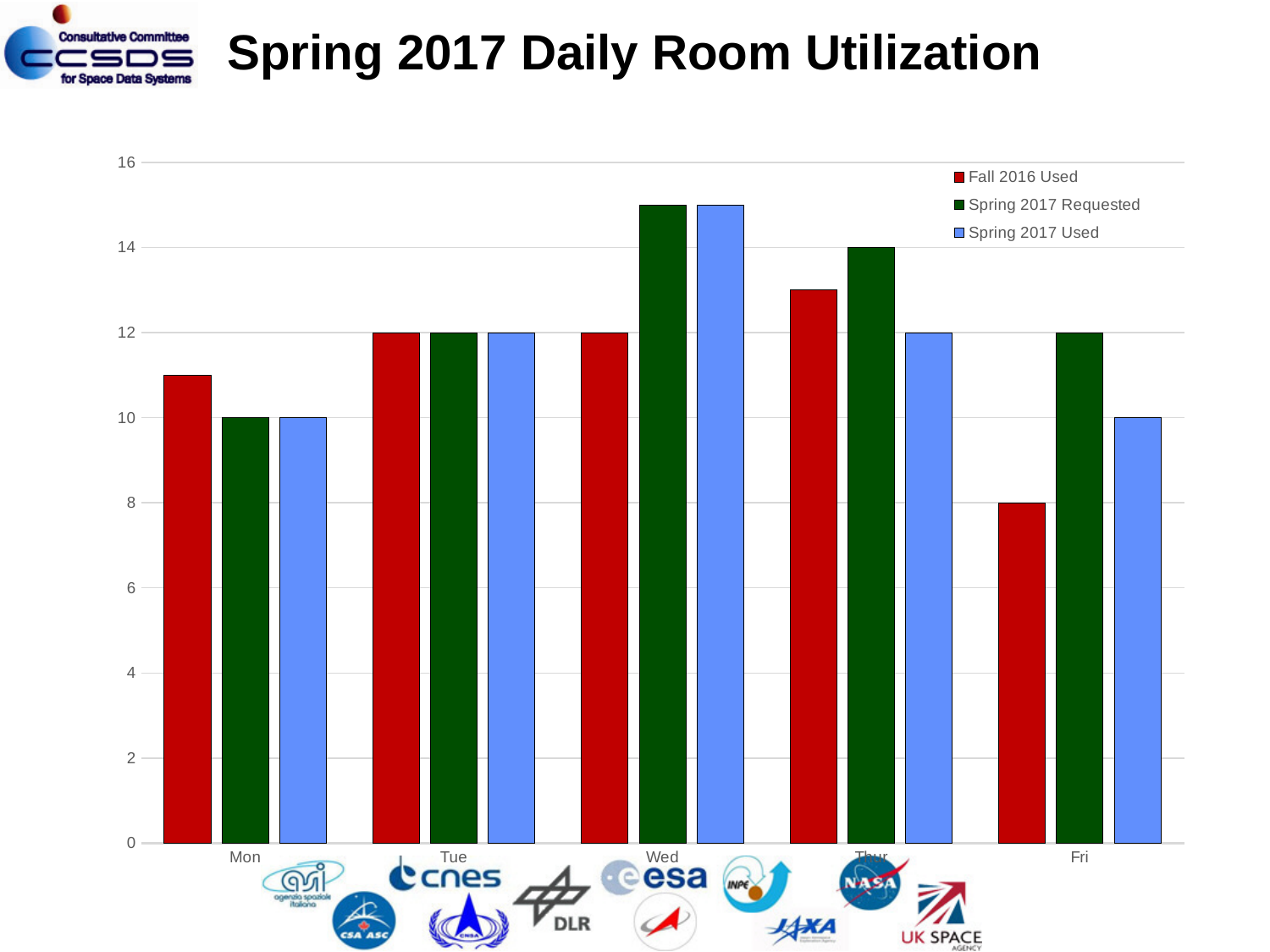
Which day has the lowest Fall 2016 Used value? Fri What is the Fall 2016 Used value for Fri? 8 How many series does the legend list? 3 Which day has the highest Spring 2017 Used value? Wed Is the Spring 2017 Requested value for Wed greater or less than 14? greater On Thur, which is larger: Spring 2017 Requested or Spring 2017 Used? Spring 2017 Requested What is the Spring 2017 Used value for Mon? 10 What is the Spring 2017 Requested value for Thur? 14 What kind of chart is shown on the slide? bar chart Is the Fall 2016 Used value for Mon greater or less than 10? greater On Fri, what is the difference between Spring 2017 Requested and Spring 2017 Used? 2 How many days are shown on the x axis? 5